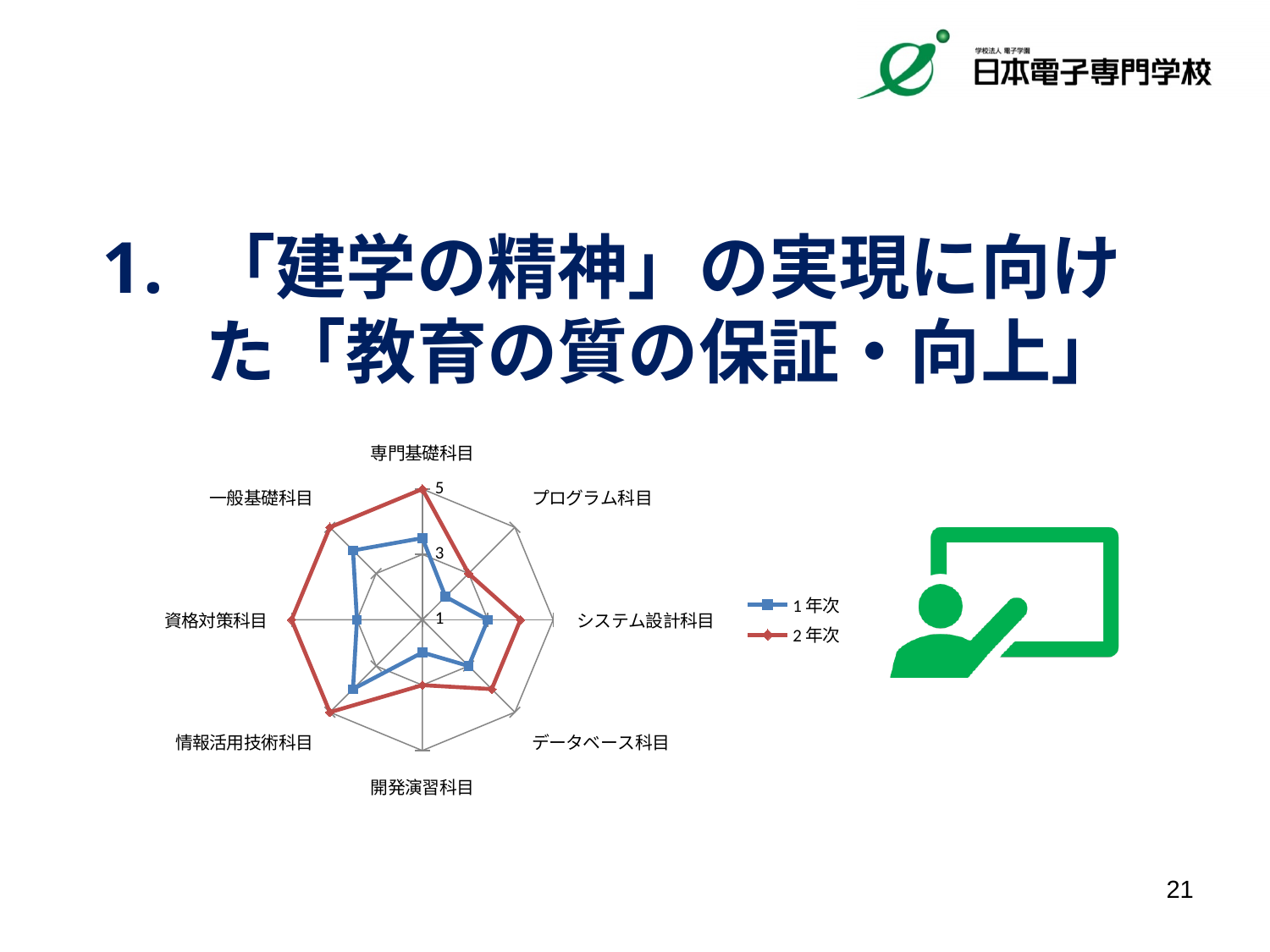
How many series does the legend of the radar chart list? 2 Is the 1年次 value for 開発演習科目 greater or less than 3? less For the 1年次 series, which is larger: the value for プログラム科目 or the value for 一般基礎科目? 一般基礎科目 Is the 2年次 value for 資格対策科目 greater or less than 3? greater For 情報活用技術科目, which series has the larger value, 1年次 or 2年次? 2年次 What are the two series named in the legend of the radar chart? 1年次 and 2年次 For 専門基礎科目, which series has the larger value, 1年次 or 2年次? 2年次 What kind of chart is shown on the slide? Radar chart Is the 2年次 value for 専門基礎科目 greater or less than 3? greater How many categories (subject areas) does the radar chart have? 8 What colour is the line for the 2年次 series in the radar chart? Red